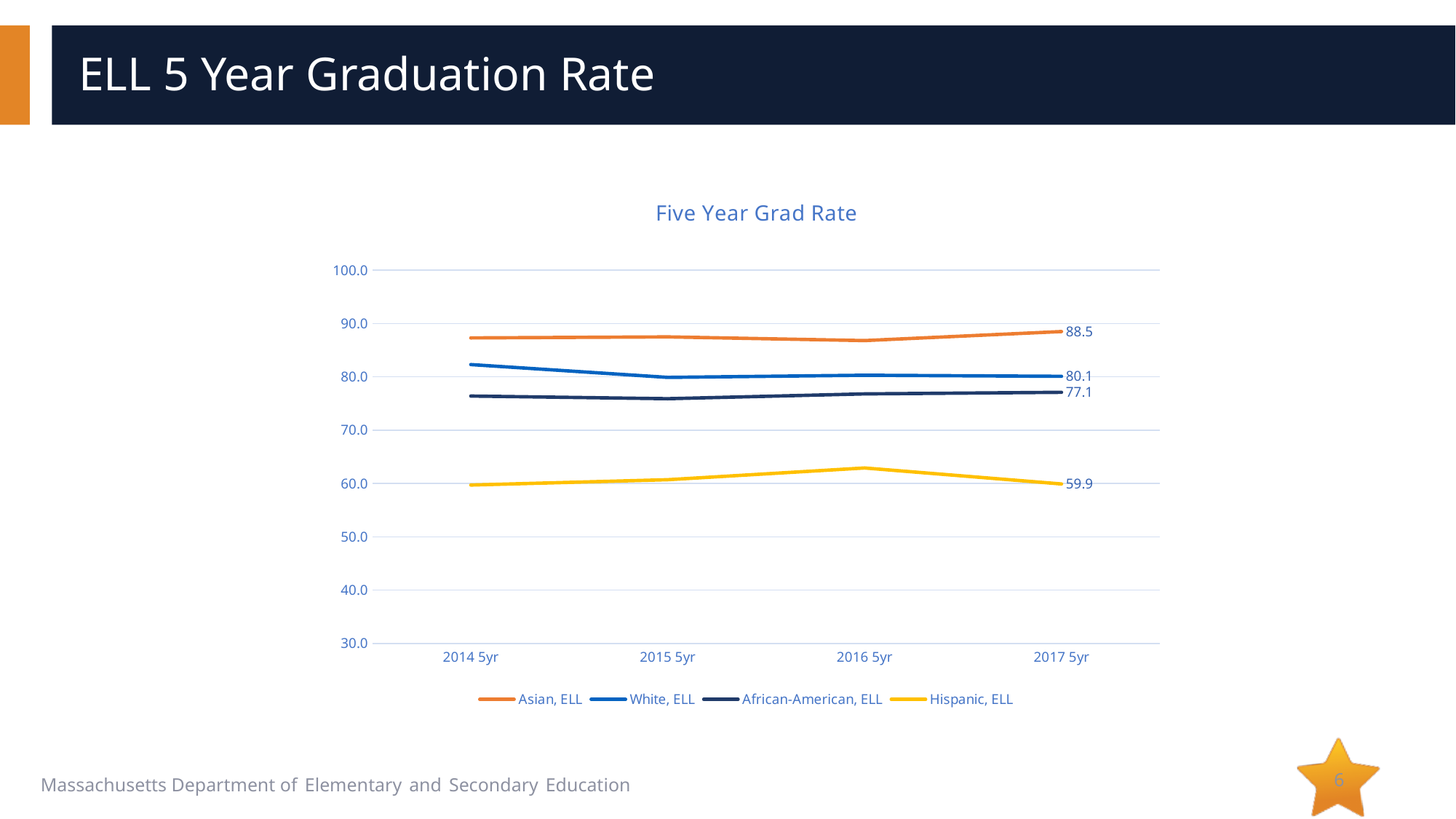
What is the value for White, ELL at 2017 5yr? 80.1 How many series does the legend list? 4 What is the difference between the Asian, ELL and Hispanic, ELL values at 2017 5yr? 28.6 How many points are on the x axis? 4 What kind of chart is shown? line chart What is the value for African-American, ELL at 2017 5yr? 77.1 Which series has the lowest value at 2017 5yr? Hispanic, ELL At 2017 5yr, which is larger: the White, ELL value or the African-American, ELL value? White, ELL Is the value for Hispanic, ELL at 2016 5yr greater or less than 60.0? greater What is the value for Hispanic, ELL at 2017 5yr? 59.9 What is the value for Asian, ELL at 2017 5yr? 88.5 Which series has the highest value at 2017 5yr? Asian, ELL